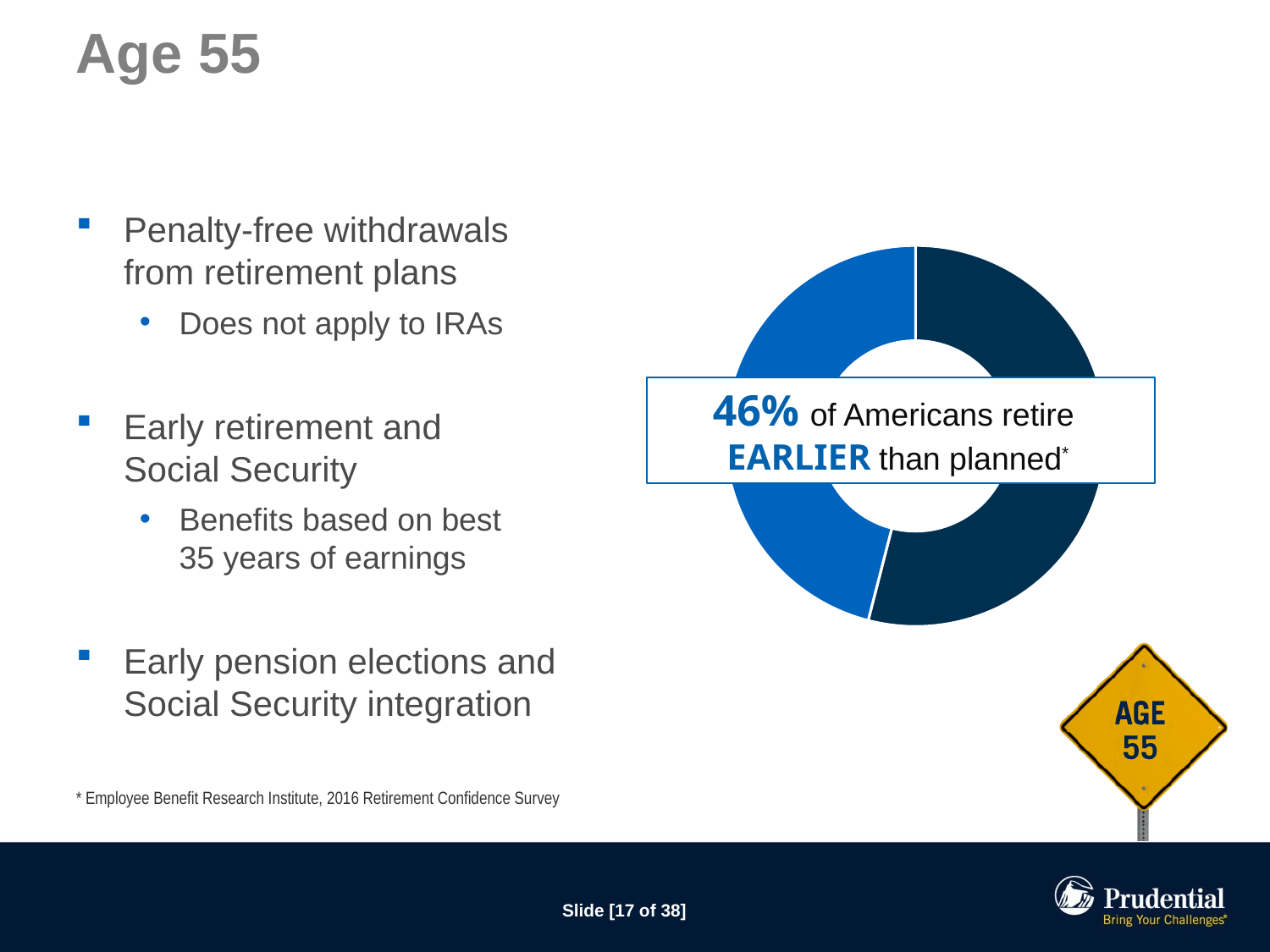
What share of the donut chart does the light blue slice represent? 46% Is the share of Americans who retire earlier than planned greater or less than 50%? less Which slice of the donut chart is larger, the dark navy slice or the light blue slice? The dark navy slice How many slices does the donut chart have? 2 What kind of chart is shown on the slide? Pie chart (donut) According to the chart, what percentage of Americans retire earlier than planned? 46% What source is cited for the 46% statistic shown with the chart? Employee Benefit Research Institute, 2016 Retirement Confidence Survey What colour is the slice representing the 46% of Americans who retire earlier than planned? Light blue